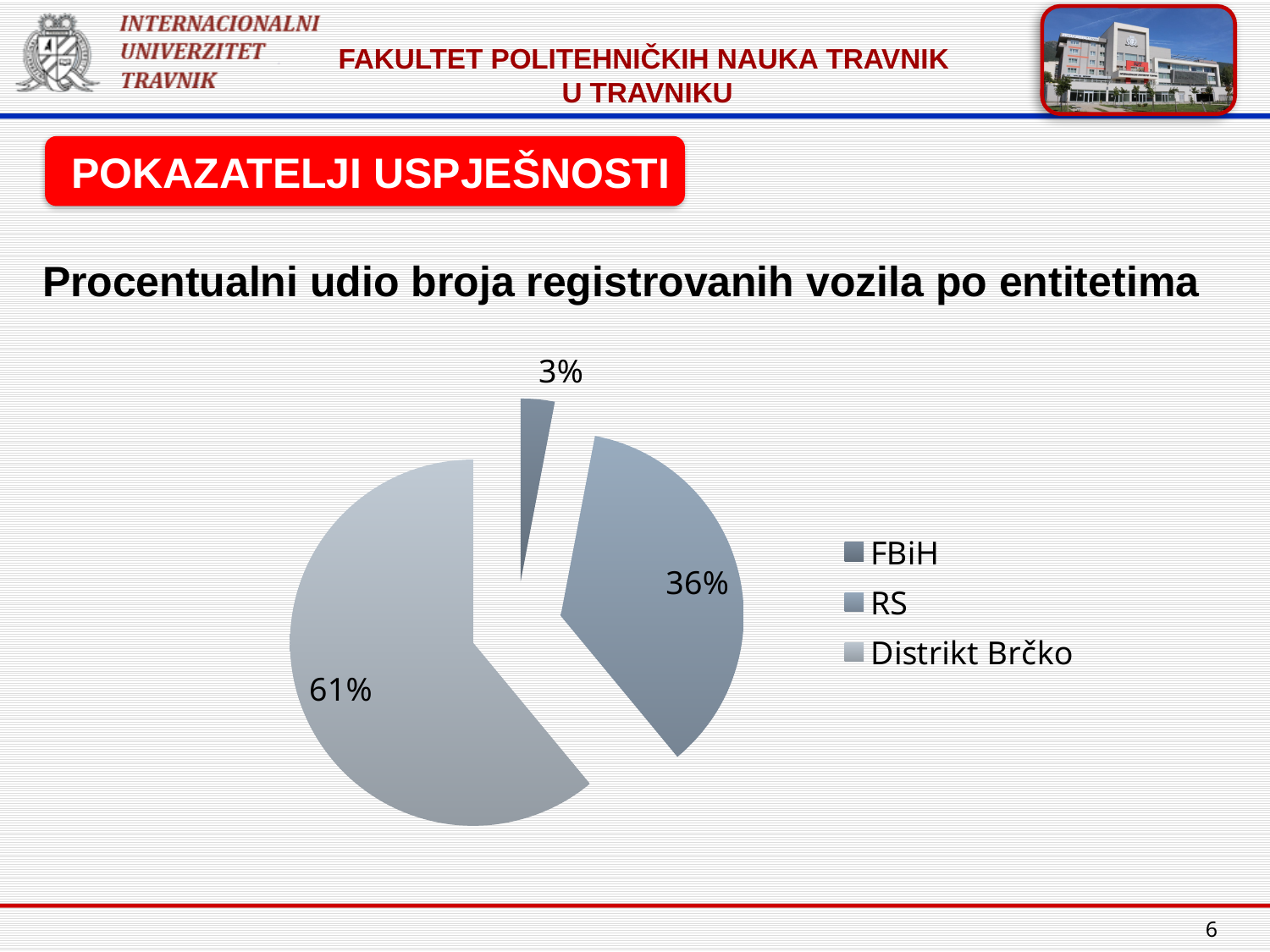
What is the value of the smallest slice of the pie chart? 3% What is the difference between the largest slice (61%) and the 36% slice? 25 percentage points How many entries does the chart legend list? 3 How many slices does the pie chart have? 3 Which legend entry is listed first in the chart legend? FBiH What type of chart is shown on the slide? pie chart What share of the pie does the slice coloured like the FBiH legend entry (the darkest slice) represent? 3% What share of the pie does the slice coloured like the RS legend entry (the medium-toned slice) represent? 36% Which is larger, the slice labelled 36% or the slice labelled 61%? 61% What is the value of the largest slice of the pie chart? 61% What share of the pie does the slice coloured like the Distrikt Brčko legend entry (the lightest slice) represent? 61% What is the title of the chart on the slide? Procentualni udio broja registrovanih vozila po entitetima